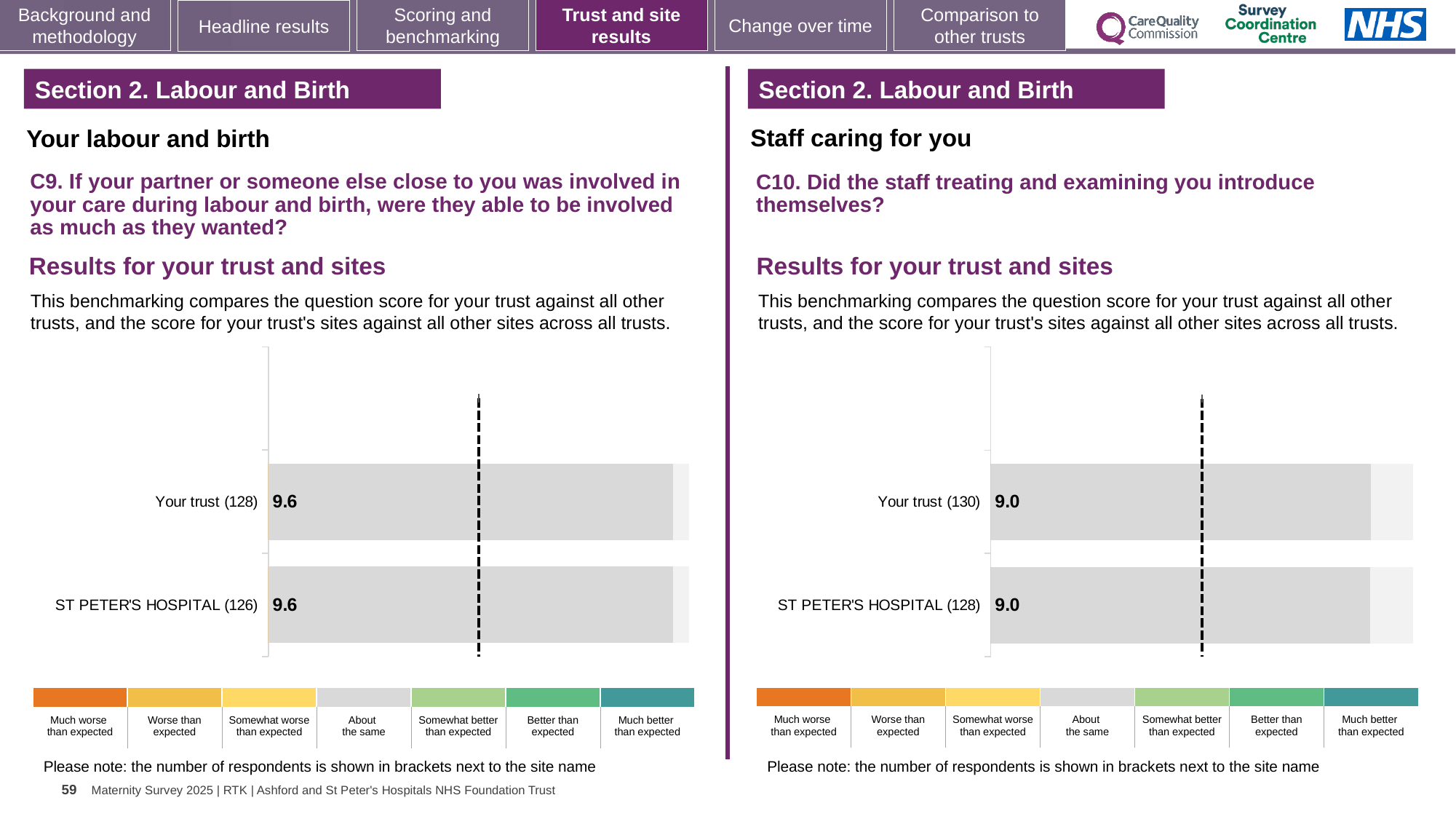
On the right chart (C10), what is the difference between the score for Your trust and the score for ST PETER'S HOSPITAL? 0.0 On the left chart (C9), how many respondents are shown in brackets for ST PETER'S HOSPITAL? 126 On the right chart (C10), what is the score for ST PETER'S HOSPITAL? 9.0 On the left chart (C9), what is the score for ST PETER'S HOSPITAL? 9.6 How many categories does the colour key below the right chart (C10) list? 7 Is the score for Your trust on the left chart (C9) larger or smaller than the score for Your trust on the right chart (C10)? larger On the left chart (C9), what is the difference between the score for Your trust and the score for ST PETER'S HOSPITAL? 0.0 On the left chart (C9), what is the score for Your trust? 9.6 What kind of chart is used on the left side of the slide (C9)? bar chart On the right chart (C10), what is the score for Your trust? 9.0 How many bars are plotted on the right chart (C10)? 2 How many bars are plotted on the left chart (C9)? 2